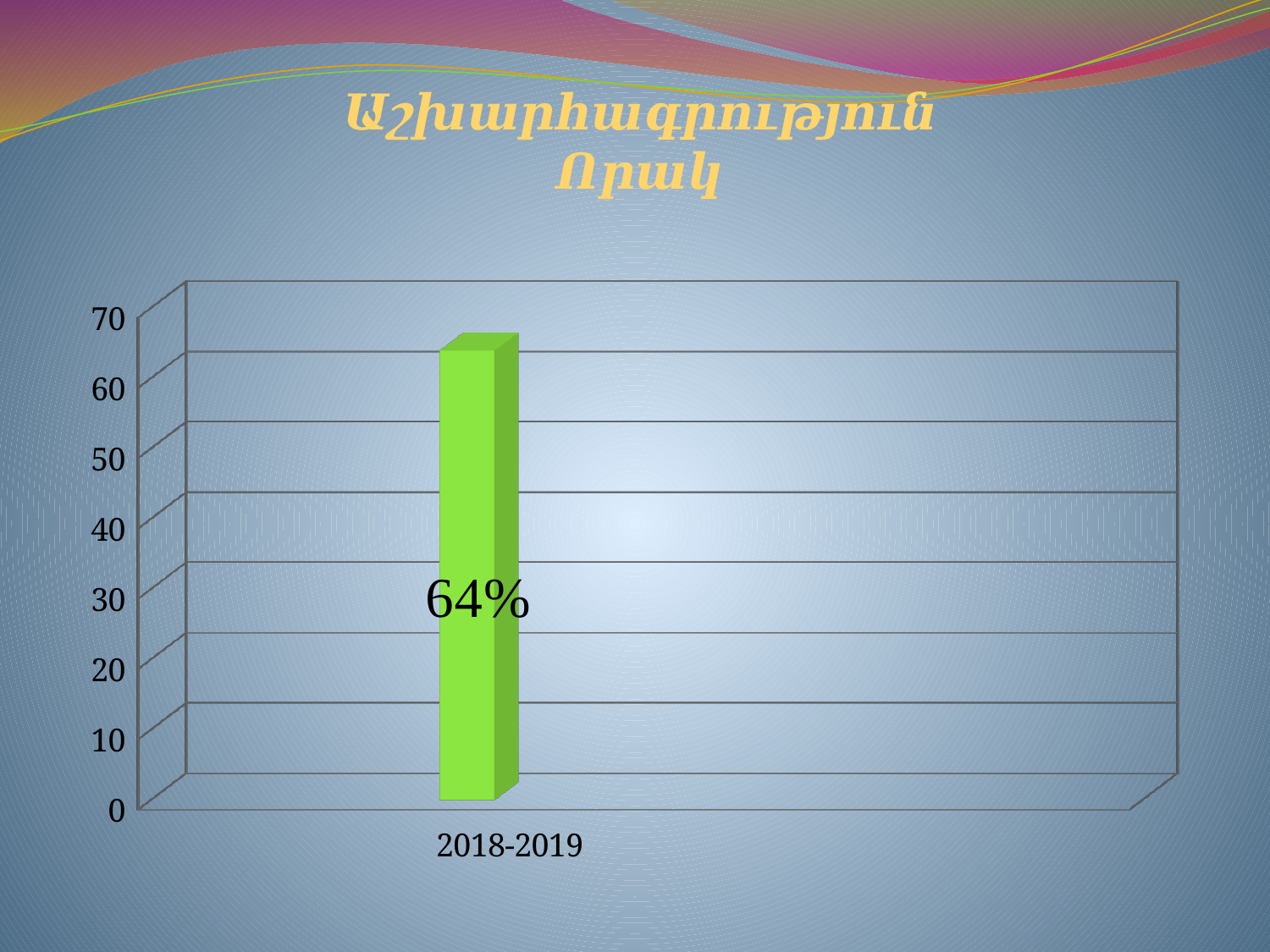
Is the value for 2018-2019 greater or less than 60? greater Is the value for 2018-2019 greater or less than 70? less Which category label appears under the bar? 2018-2019 What colour is the bar in the chart? green What is the highest value shown on the vertical axis? 70 What kind of chart is shown on the slide? bar chart How many categories are plotted on the x axis? 1 What is the value shown for 2018-2019? 64%